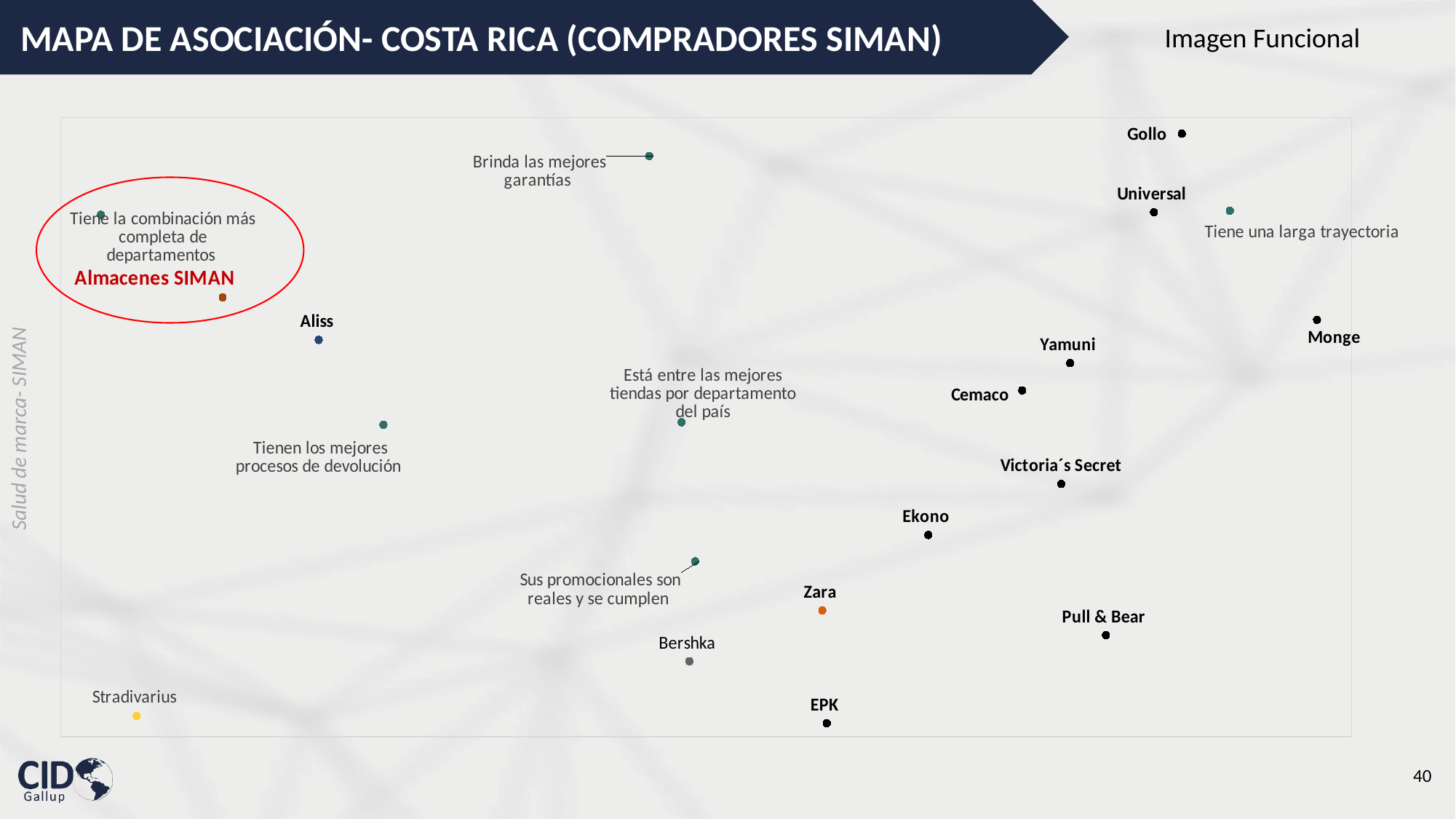
Which brand is plotted furthest to the left on the map? Stradivarius How many attribute statements (functional image items) are plotted on the map? 6 Which attribute is plotted inside the red circle together with Almacenes SIMAN? Tiene la combinación más completa de departamentos Which brand is plotted closest to the attribute 'Tiene una larga trayectoria'? Universal Which brand is highlighted with a red circle on the map? Almacenes SIMAN Which brand is plotted highest (nearest the top) on the map? Gollo Which brand is plotted furthest to the right on the map? Monge What is the title of the chart on the slide? MAPA DE ASOCIACIÓN- COSTA RICA (COMPRADORES SIMAN) Which brand is plotted closest to the attribute 'Brinda las mejores garantías'? Aliss What kind of chart is shown on the slide? Scatter chart (association map) How many brands are plotted on the association map? 14 Which brand is plotted closest to the attribute 'Tiene la combinación más completa de departamentos'? Almacenes SIMAN